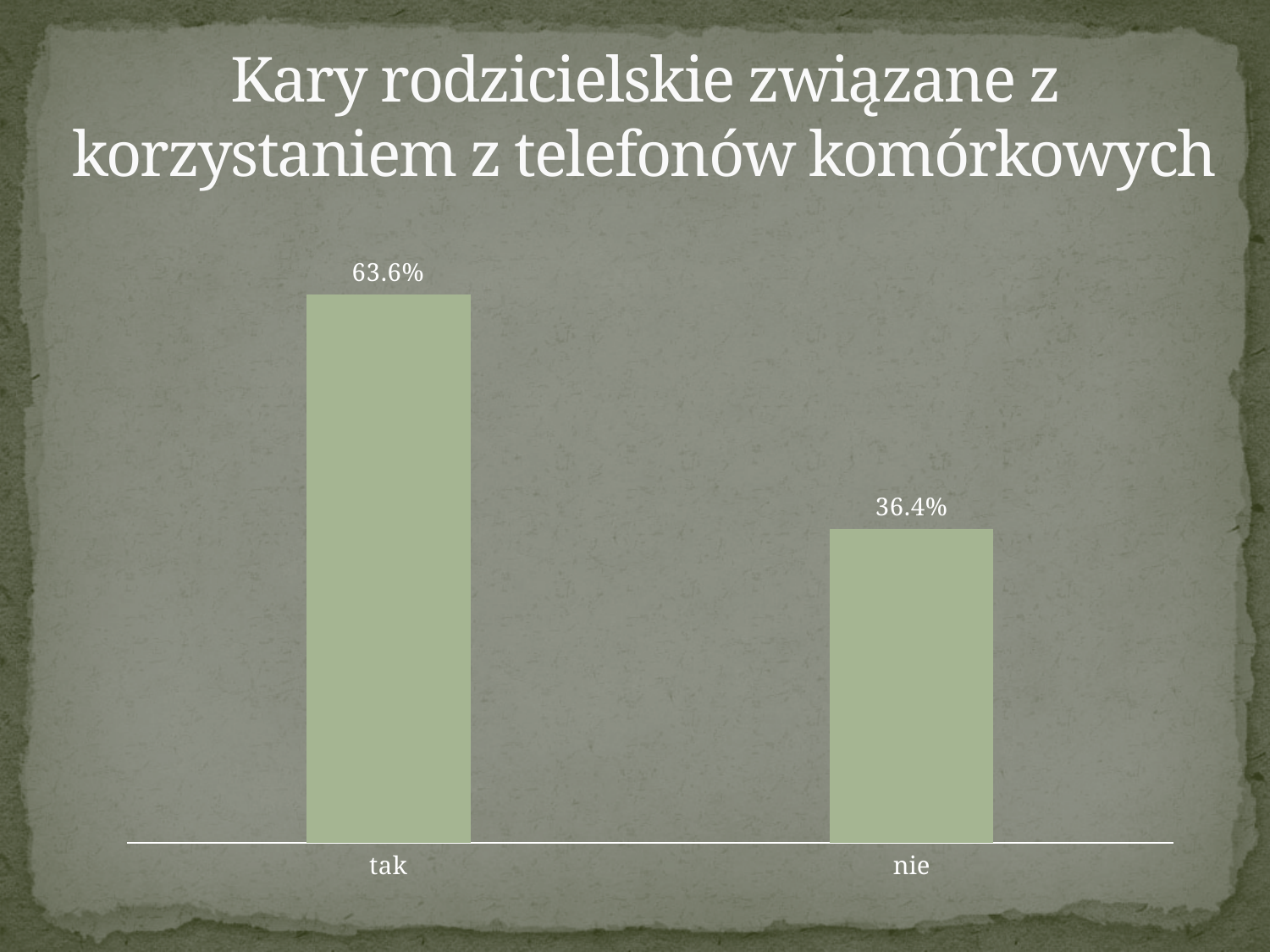
What is the title of the slide? Kary rodzicielskie związane z korzystaniem z telefonów komórkowych What is the value for "nie"? 36.4% Which category has the highest value? tak What colour are the bars in the chart? green Which is larger, the value for "tak" or the value for "nie"? tak What is the difference between the values for "tak" and "nie"? 27.2% What is the value for "tak"? 63.6% What is the total of the two values shown? 100% What kind of chart is shown on the slide? bar chart Do the values rise or fall from left to right along the x axis? fall How many categories are shown on the x axis? 2 Which category has the lowest value? nie